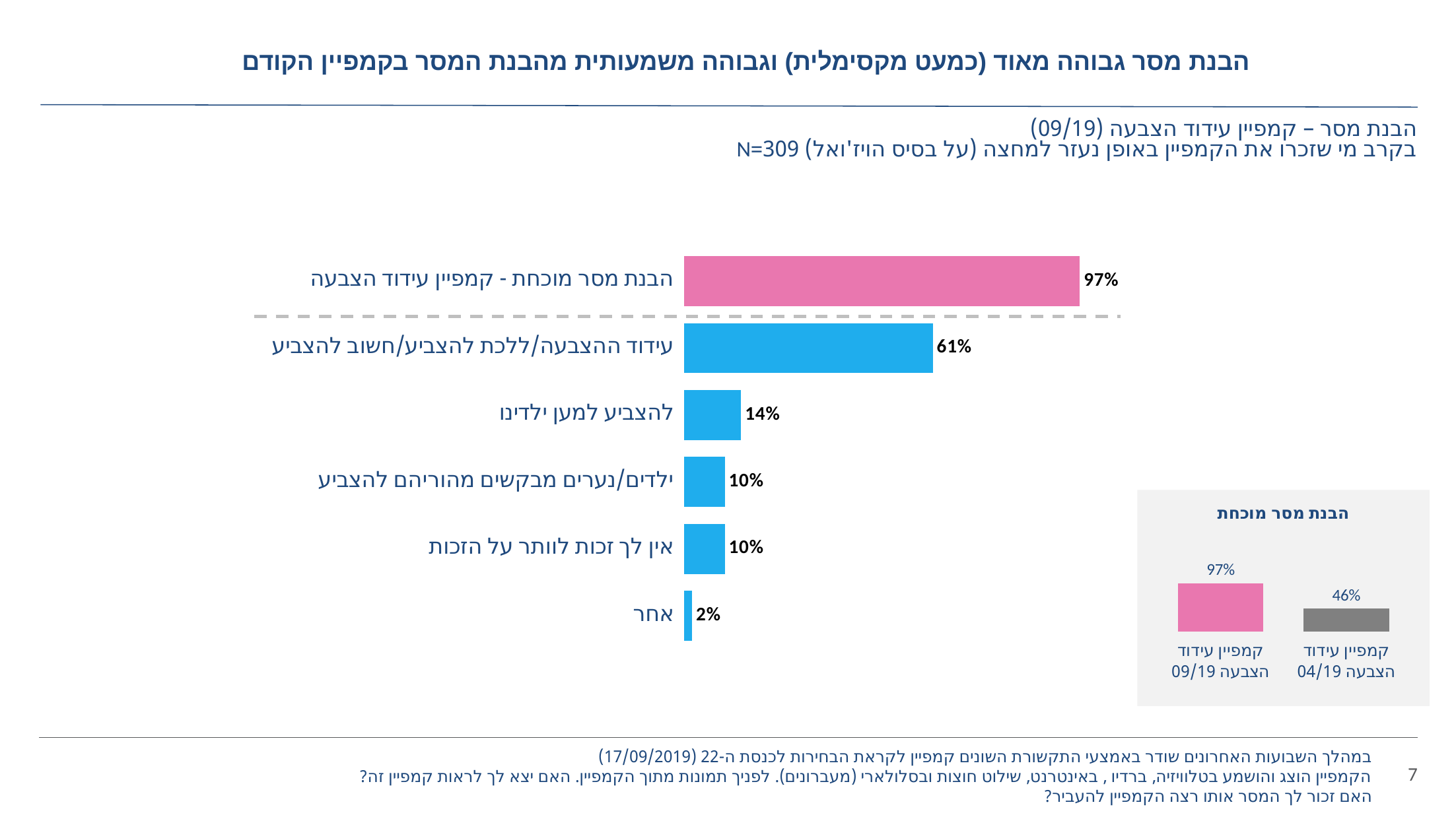
In the main bar chart, which is larger: "להצביע למען ילדינו" or "ילדים/נערים מבקשים מהוריהם להצביע"? להצביע למען ילדינו In the main bar chart, what is the value for "עידוד ההצבעה/ללכת להצביע/חשוב להצביע"? 61% In the small inset chart at the bottom right, what is the value for "קמפיין עידוד הצבעה 04/19"? 46% How many categories are shown in the main bar chart? 6 In the main bar chart, which category has the highest value? הבנת מסר מוכחת - קמפיין עידוד הצבעה In the main bar chart, what is the difference between "הבנת מסר מוכחת - קמפיין עידוד הצבעה" and "עידוד ההצבעה/ללכת להצביע/חשוב להצביע"? 36% What is the title of the small inset chart at the bottom right? הבנת מסר מוכחת What type of chart is the main chart on the slide? Bar chart In the main bar chart, what is the value for "אחר"? 2% In the main bar chart, which category has the lowest value? אחר In the small inset chart at the bottom right, what is the difference between the 09/19 campaign and the 04/19 campaign? 51% In the main bar chart, what is the value for "להצביע למען ילדינו"? 14%